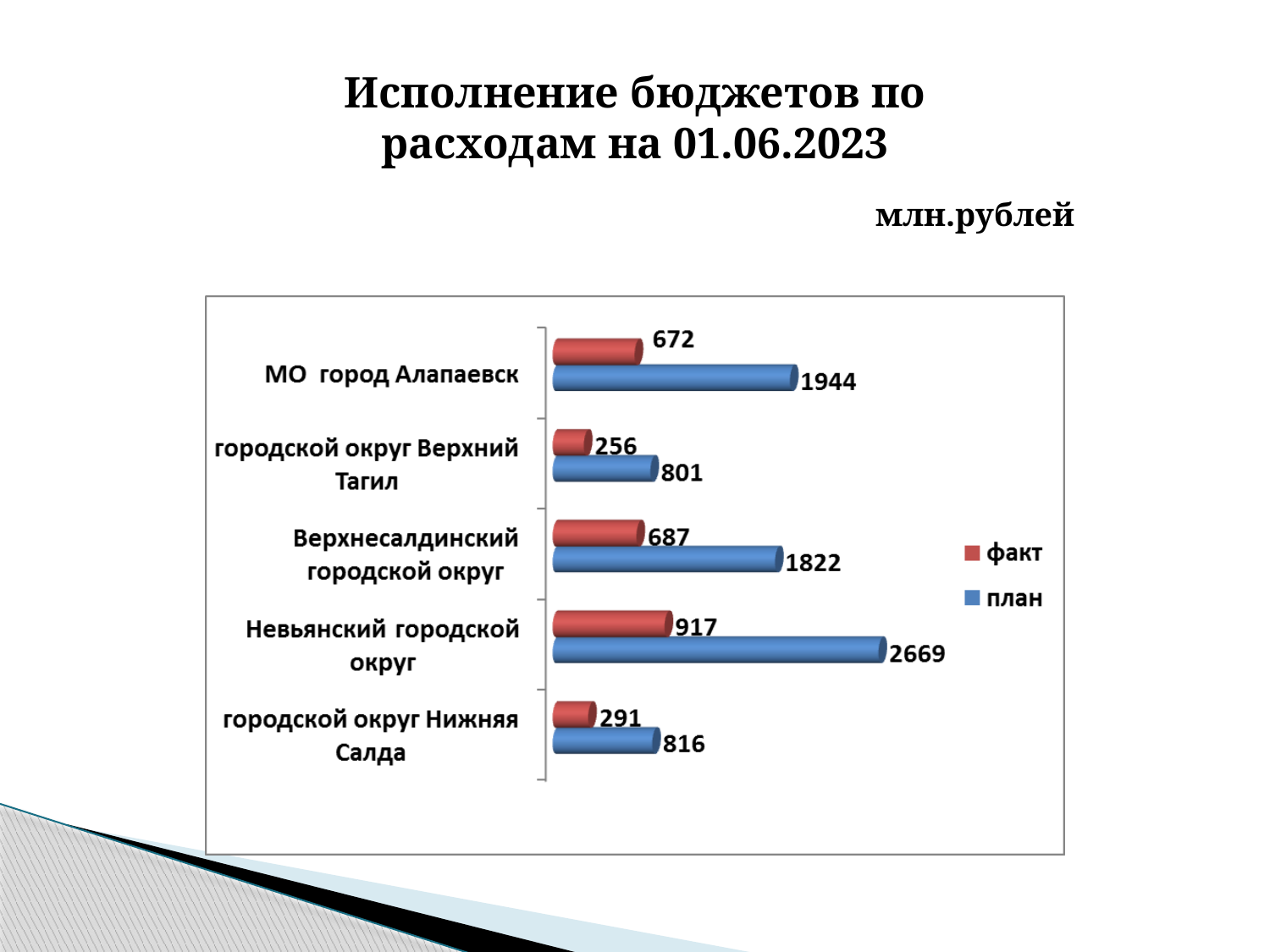
What is the факт value for городской округ Нижняя Салда? 291 What kind of chart is shown on the slide? bar chart Which is larger: the факт value for МО город Алапаевск or the факт value for Верхнесалдинский городской округ? Верхнесалдинский городской округ How many series does the legend list? 2 Which category has the lowest план value? городской округ Верхний Тагил What is the факт value for МО город Алапаевск? 672 Which colour represents the план series? blue What is the план value for городской округ Верхний Тагил? 801 How many categories are shown on the chart? 5 What is the план value for Невьянский городской округ? 2669 Which category has the highest факт value? Невьянский городской округ What is the difference between план and факт for Верхнесалдинский городской округ? 1135